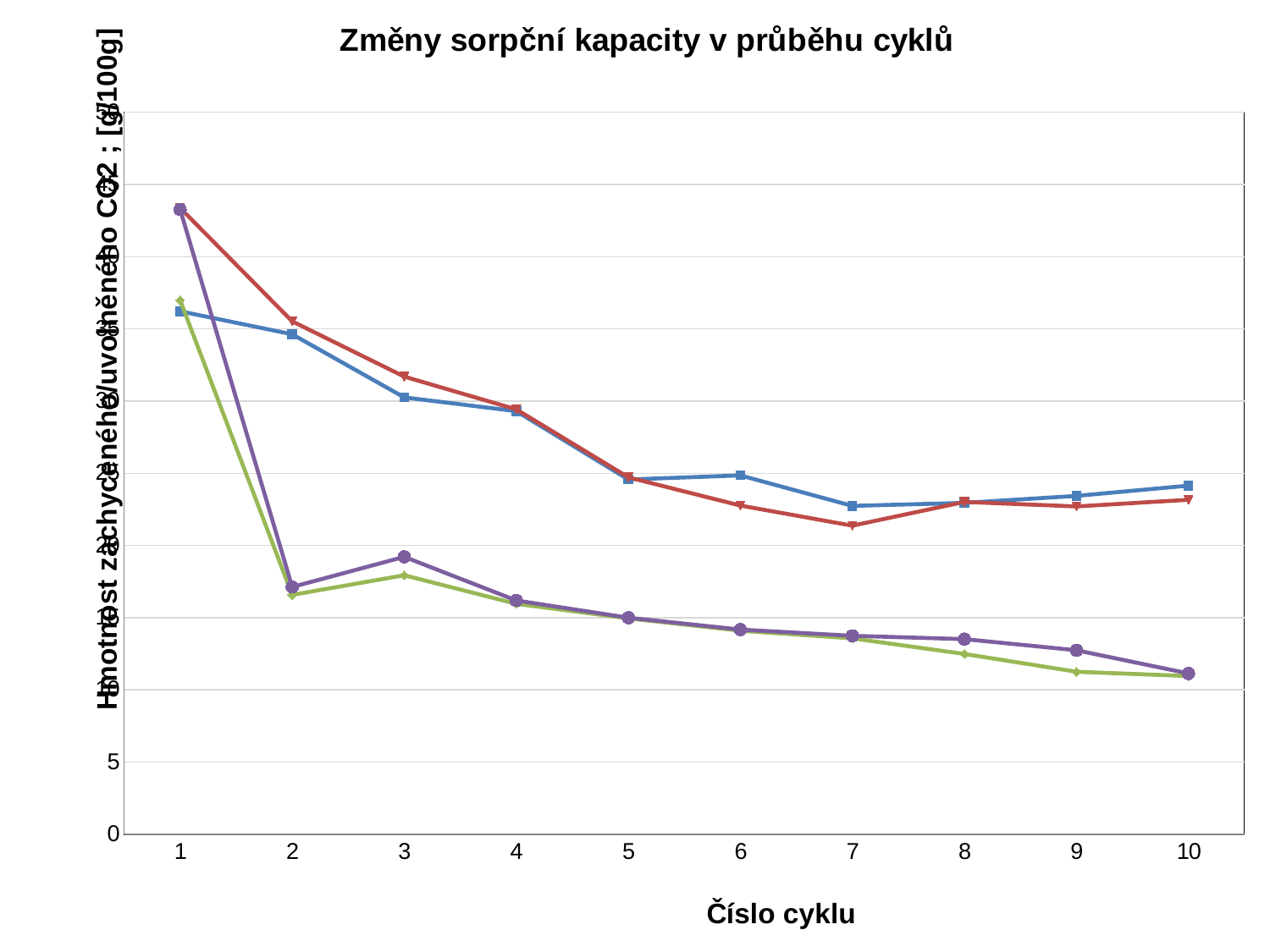
Do the values of the red line generally rise or fall as the cycle number increases? fall At which cycle does the red line reach its highest value? 1 Is the value of the green line at cycle 10 greater or less than 15? less At which cycle does the purple line reach its lowest value? 10 Is the value of the purple line at cycle 2 greater or less than 20? less What is the title of the chart? Změny sorpční kapacity v průběhu cyklů Is the value of the red line at cycle 1 greater or less than 40? greater How many lines (series) are plotted on the chart? 4 What is the label of the x axis? Číslo cyklu What kind of chart is shown on the slide? line chart How many cycles are plotted along the x axis? 10